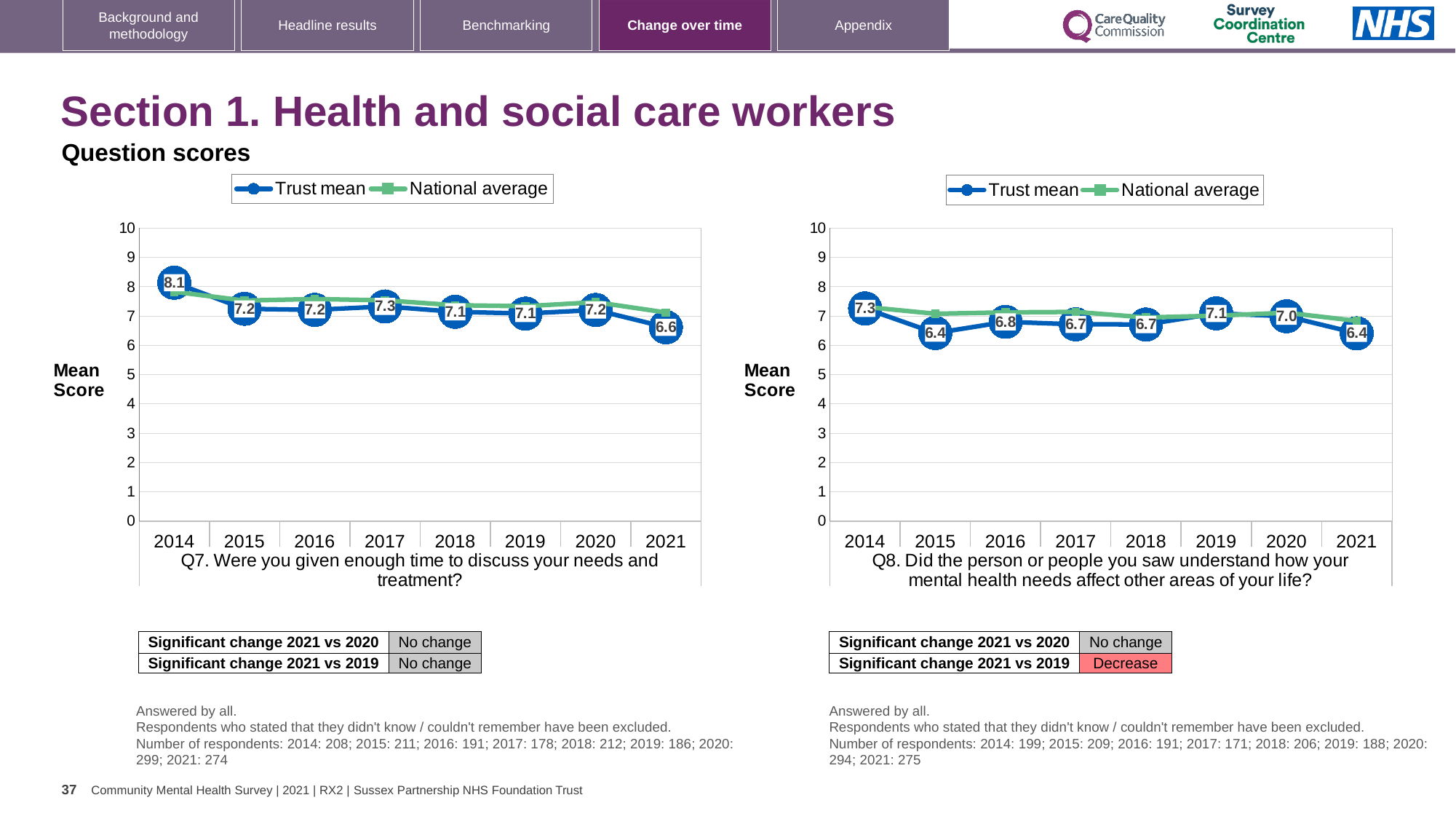
How many series does the legend of the Q8 chart (right) list? 2 How many years are plotted on the x axis of the Q7 chart (left)? 8 In the Q7 chart (left), which year has the highest Trust mean? 2014 In the Q7 chart (left), what is the Trust mean for 2021? 6.6 In the Q8 chart (right), what is the Trust mean for 2019? 7.1 In the Q8 chart (right), which year has the highest Trust mean? 2014 In the Q8 chart (right), is the Trust mean for 2020 greater or less than the Trust mean for 2021? greater In the Q7 chart (left), which year has the lowest Trust mean? 2021 In the Q7 chart (left), what is the difference between the Trust mean in 2014 and in 2021? 1.5 In the Q7 chart (left), what is the Trust mean for 2014? 8.1 In the Q8 chart (right), is the National average for 2014 greater or less than 6? greater In the Q8 chart (right), what is the Trust mean for 2016? 6.8